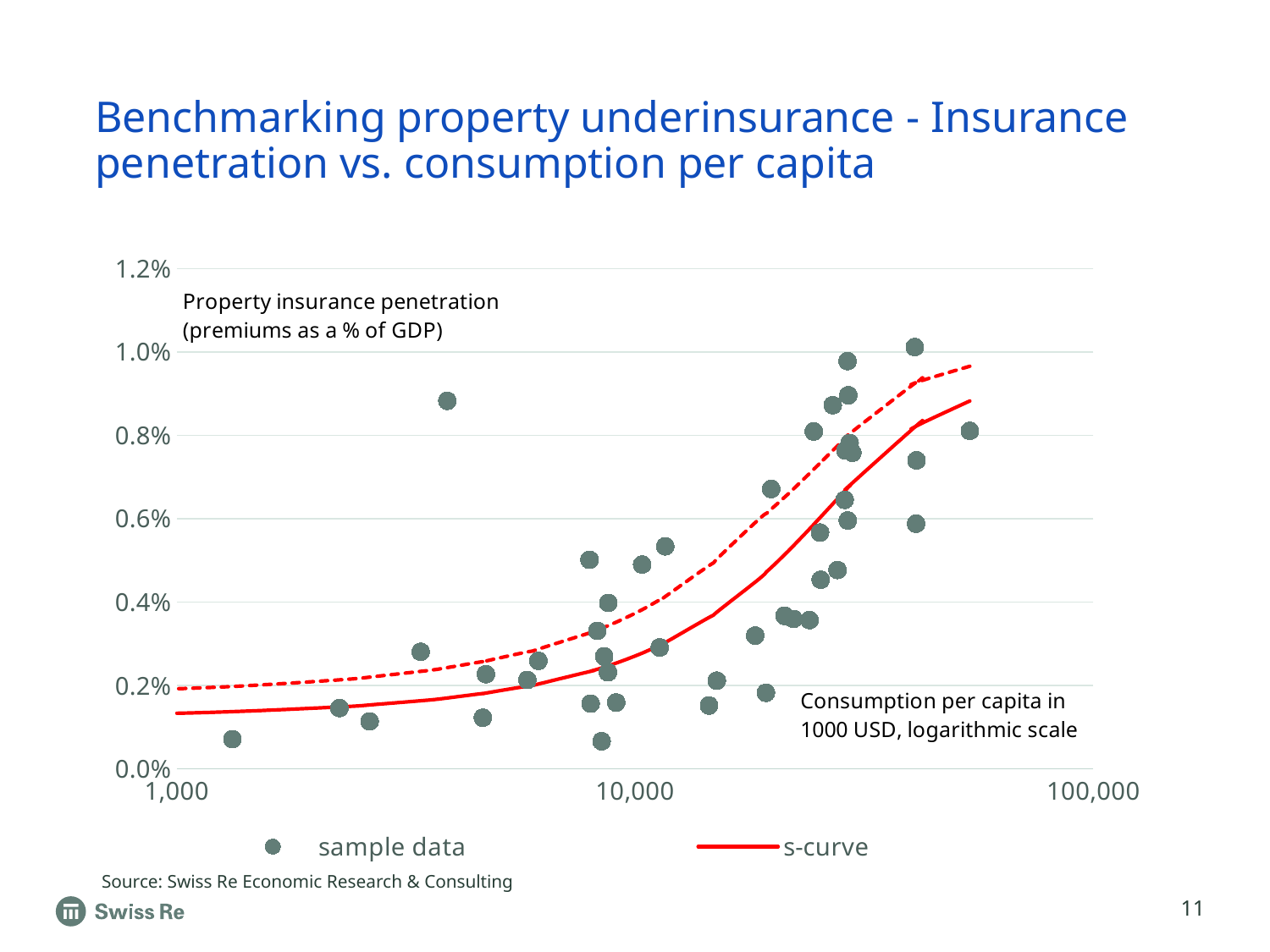
What are the two entries listed in the chart legend? sample data, s-curve Does the s-curve rise or fall as consumption per capita increases along the x axis? rise Is the value of the s-curve at its right-hand end greater or less than 0.6%? greater Is the value of the s-curve at a consumption per capita of 1,000 greater or less than 0.2%? less Is the value of the s-curve at a consumption per capita of 10,000 greater or less than 0.4%? less What scale is used on the x axis of the chart? logarithmic scale How many series does the legend list? 2 What kind of chart is shown on the slide? scatter chart